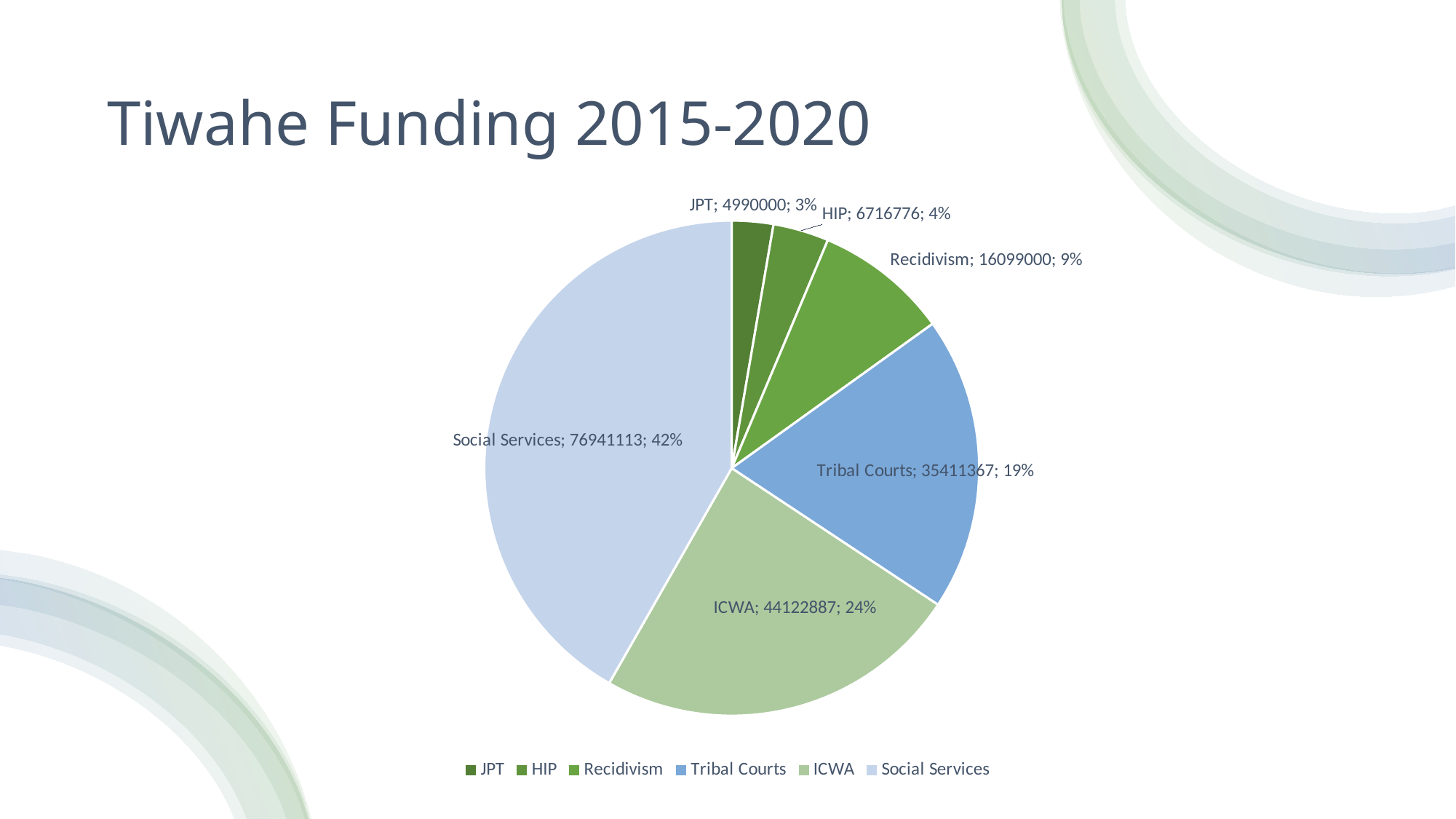
What is the difference between the Social Services and ICWA funding values? 32818226 Which category received the largest share of funding? Social Services What is the funding value for ICWA? 44122887 What kind of chart is shown on the slide? Pie chart What is the title of the chart? Tiwahe Funding 2015-2020 Which received more funding, Recidivism or Tribal Courts? Tribal Courts What is the funding value for Tribal Courts? 35411367 What percentage share of the pie does Recidivism represent? 9% How many categories are shown in the pie chart? 6 What percentage share of the pie does Social Services represent? 42% What is the funding value for HIP? 6716776 Which category received the smallest share of funding? JPT